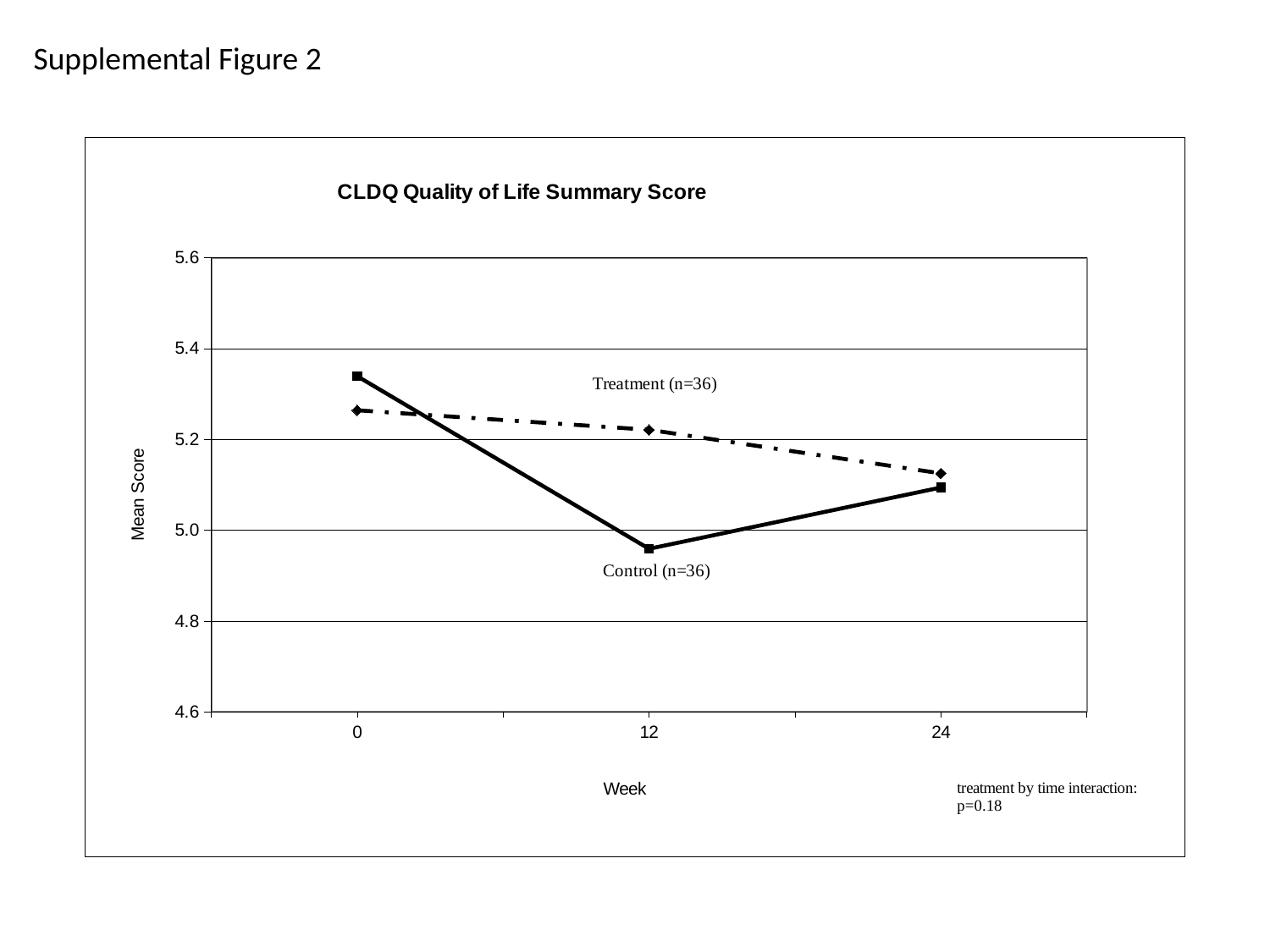
At which week does the Control (n=36) group reach its lowest mean score? 12 How many series are plotted on the chart? 2 At week 12, which group has the higher mean score, Treatment (n=36) or Control (n=36)? Treatment (n=36) Is the Control (n=36) value at week 0 greater or less than 5.2? greater How many time points (weeks) are plotted along the x axis? 3 What is the title of the chart? CLDQ Quality of Life Summary Score What is the label of the y axis? Mean Score Is the Treatment (n=36) value at week 24 greater or less than 5.0? greater Is the Control (n=36) value at week 12 greater or less than 5.2? less At week 0, which group has the higher mean score, Treatment (n=36) or Control (n=36)? Control (n=36) What kind of chart is shown on the slide? line chart